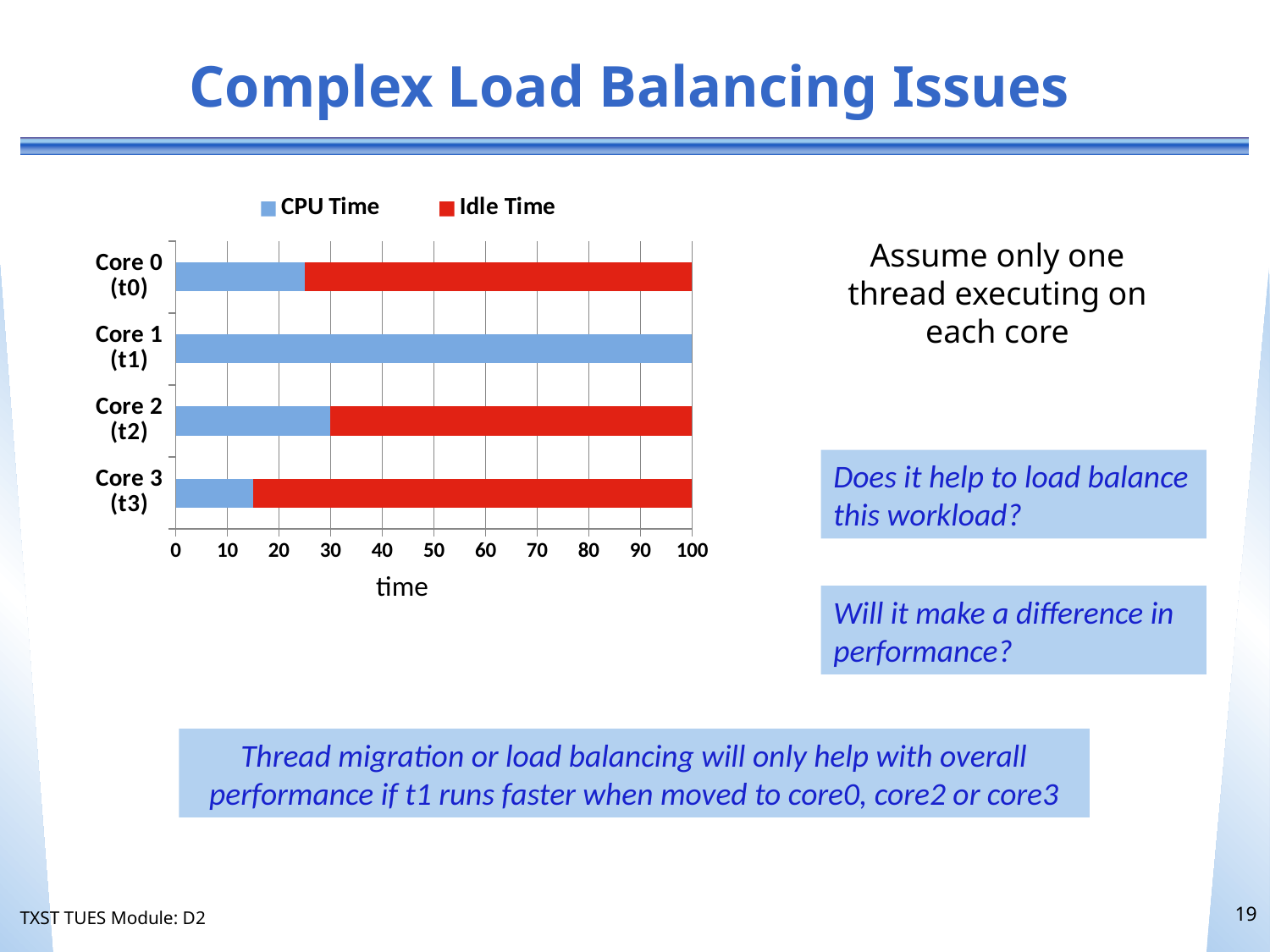
Is the CPU Time for Core 0 (t0) greater or less than 30? less What kind of chart is shown on the slide? bar chart What is the CPU Time value for Core 1 (t1)? 100 How many cores (categories) are plotted on the chart? 4 Which core has the lowest CPU Time? Core 3 (t3) What is the total length (CPU Time plus Idle Time) of the stacked bar for Core 2 (t2)? 100 Is the CPU Time for Core 3 (t3) greater or less than 20? less What is the CPU Time value for Core 2 (t2)? 30 How many series does the legend list? 2 What is the label on the x axis of the chart? time Which has more CPU Time, Core 0 (t0) or Core 3 (t3)? Core 0 (t0) Which core has the highest CPU Time? Core 1 (t1)